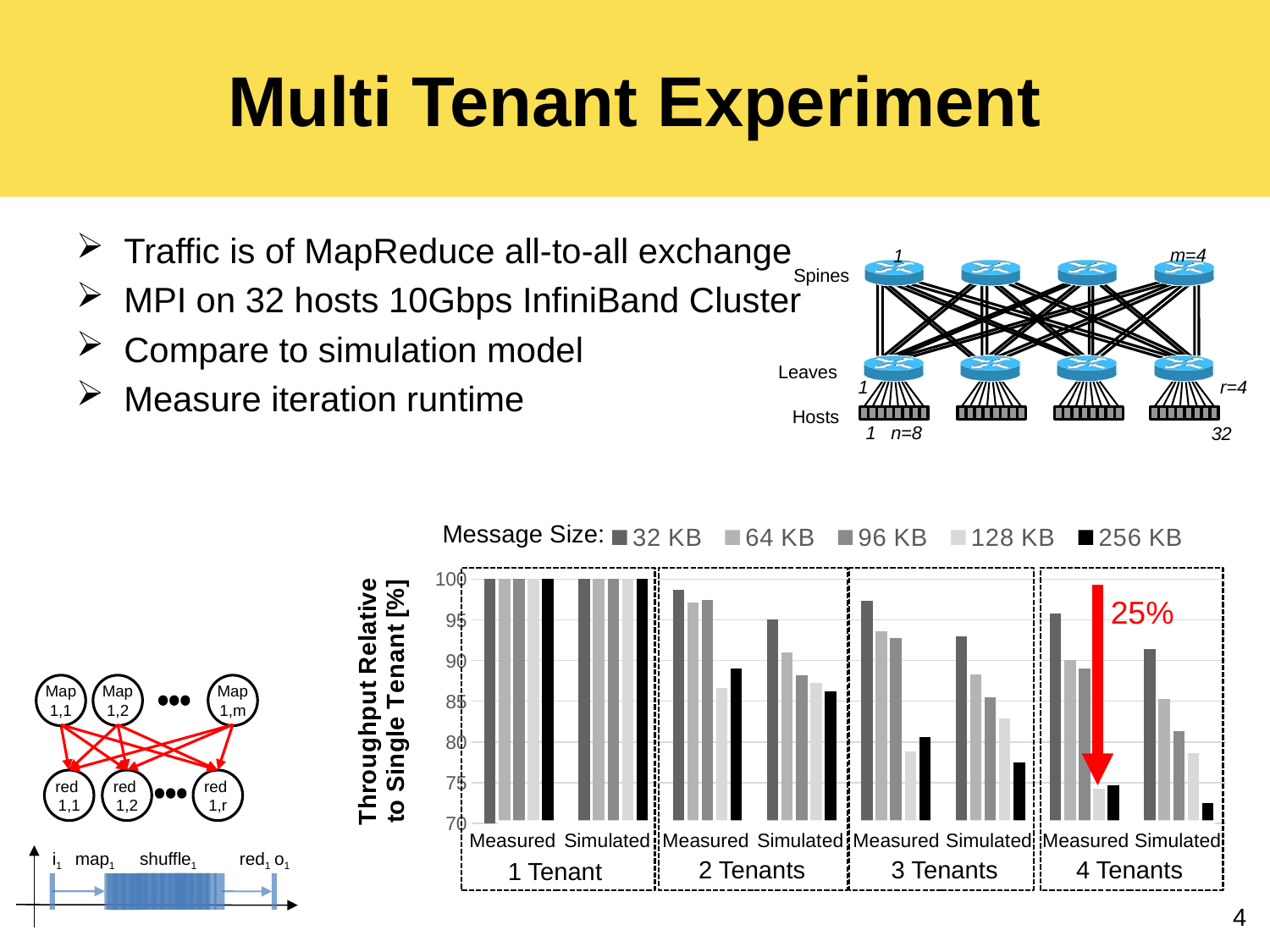
What is the throughput relative to single tenant for the 32 KB message size in the 1 Tenant Measured group? 100 Which is larger in the 3 Tenants groups: the 32 KB Measured value or the 32 KB Simulated value? 32 KB Measured What percentage is printed next to the red arrow in the 4 Tenants group? 25% Is the value for 256 KB in the 4 Tenants Simulated group greater or less than 75? less How many message sizes does the legend of the throughput chart list? 5 Is the value for 32 KB in the 2 Tenants Measured group greater or less than 95? greater What is the y-axis title of the throughput chart? Throughput Relative to Single Tenant [%] As the number of tenants increases from 1 to 4, does the throughput relative to single tenant rise or fall? fall Which bar in the throughput chart is the lowest? 256 KB in 4 Tenants Simulated Is the value for 256 KB in the 3 Tenants Simulated group greater or less than 80? less Which tenant group has the highest throughput relative to single tenant across all message sizes? 1 Tenant What kind of chart is shown at the bottom right of the slide? bar chart